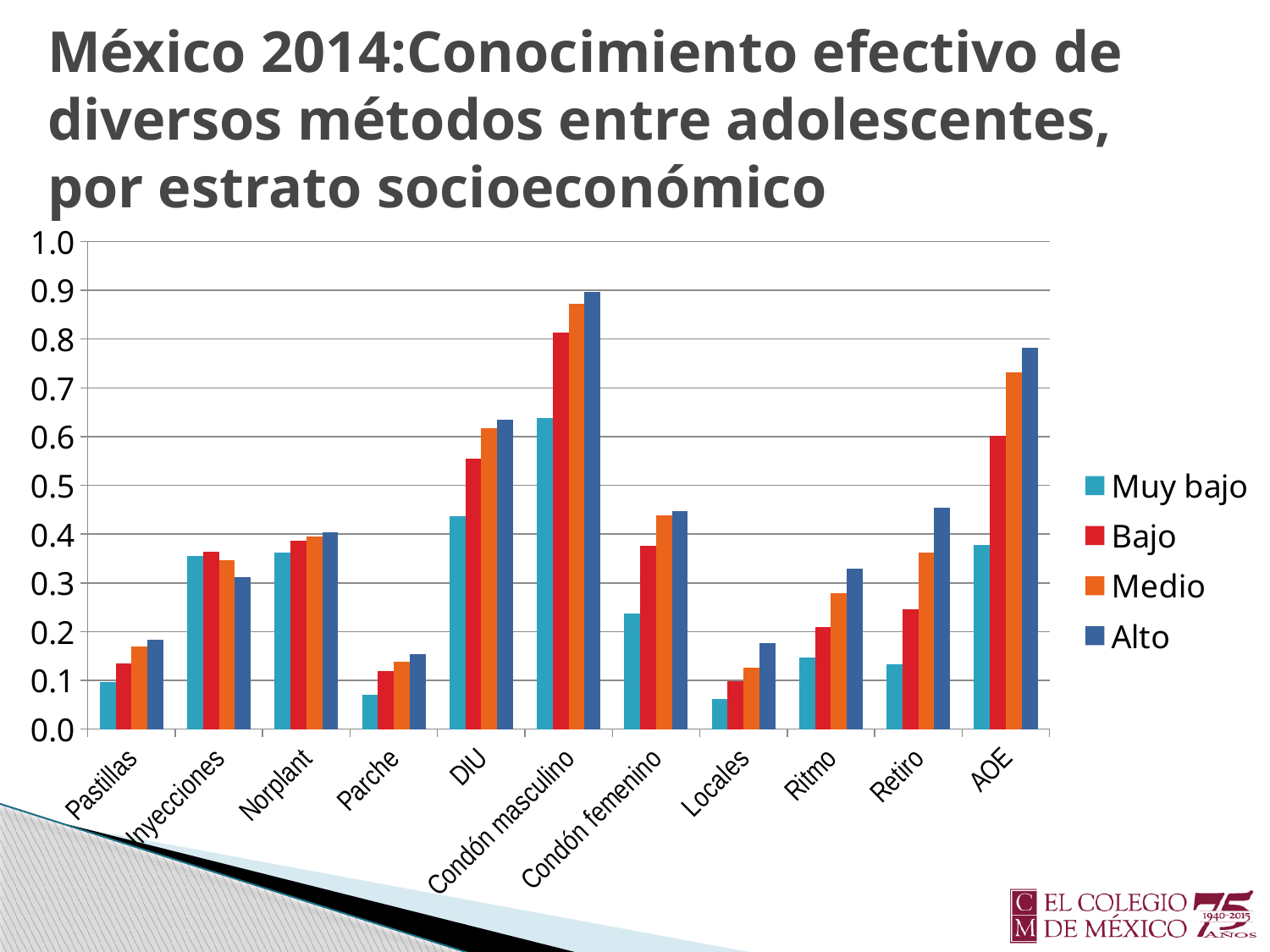
Which category and series has the highest bar in the chart? Condón masculino, Alto Is the value for Locales in the Alto series greater or less than 0.2? less Which category has the lowest value for the Muy bajo series? Locales Which is larger for the Bajo series: AOE or Retiro? AOE What kind of chart is shown on the slide? bar chart Is the value for Parche in the Muy bajo series greater or less than 0.1? less How many series does the legend list? 4 Which category has the highest value for the Muy bajo series? Condón masculino Which is larger for the Alto series: Inyecciones or Norplant? Norplant How many contraceptive method categories are shown on the x axis? 11 Is the value for AOE in the Alto series greater or less than 0.7? greater